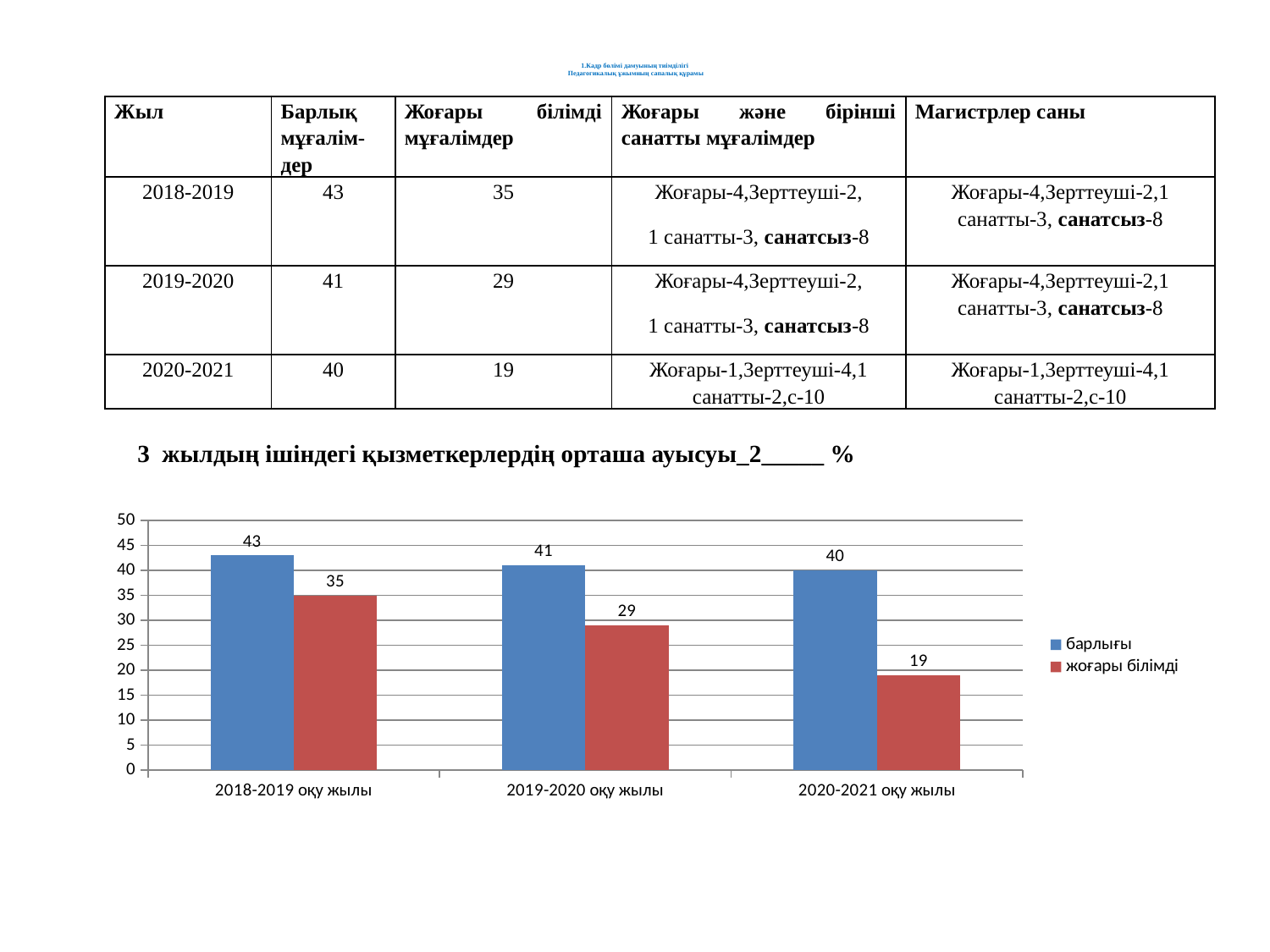
In which year is the барлығы value highest? 2018-2019 оқу жылы What is the value of жоғары білімді for 2020-2021 оқу жылы? 19 In which year is the жоғары білімді value lowest? 2020-2021 оқу жылы What is the value of барлығы for 2018-2019 оқу жылы? 43 What is the value of жоғары білімді for 2019-2020 оқу жылы? 29 What is the difference between барлығы and жоғары білімді for 2020-2021 оқу жылы? 21 Which is larger: жоғары білімді for 2018-2019 оқу жылы or барлығы for 2020-2021 оқу жылы? барлығы for 2020-2021 оқу жылы How many categories are shown on the x axis of the chart? 3 Does the жоғары білімді series rise or fall across the years on the x axis? fall How many series does the chart legend list? 2 What colour are the барлығы bars in the chart? blue What type of chart is shown on the slide? bar chart